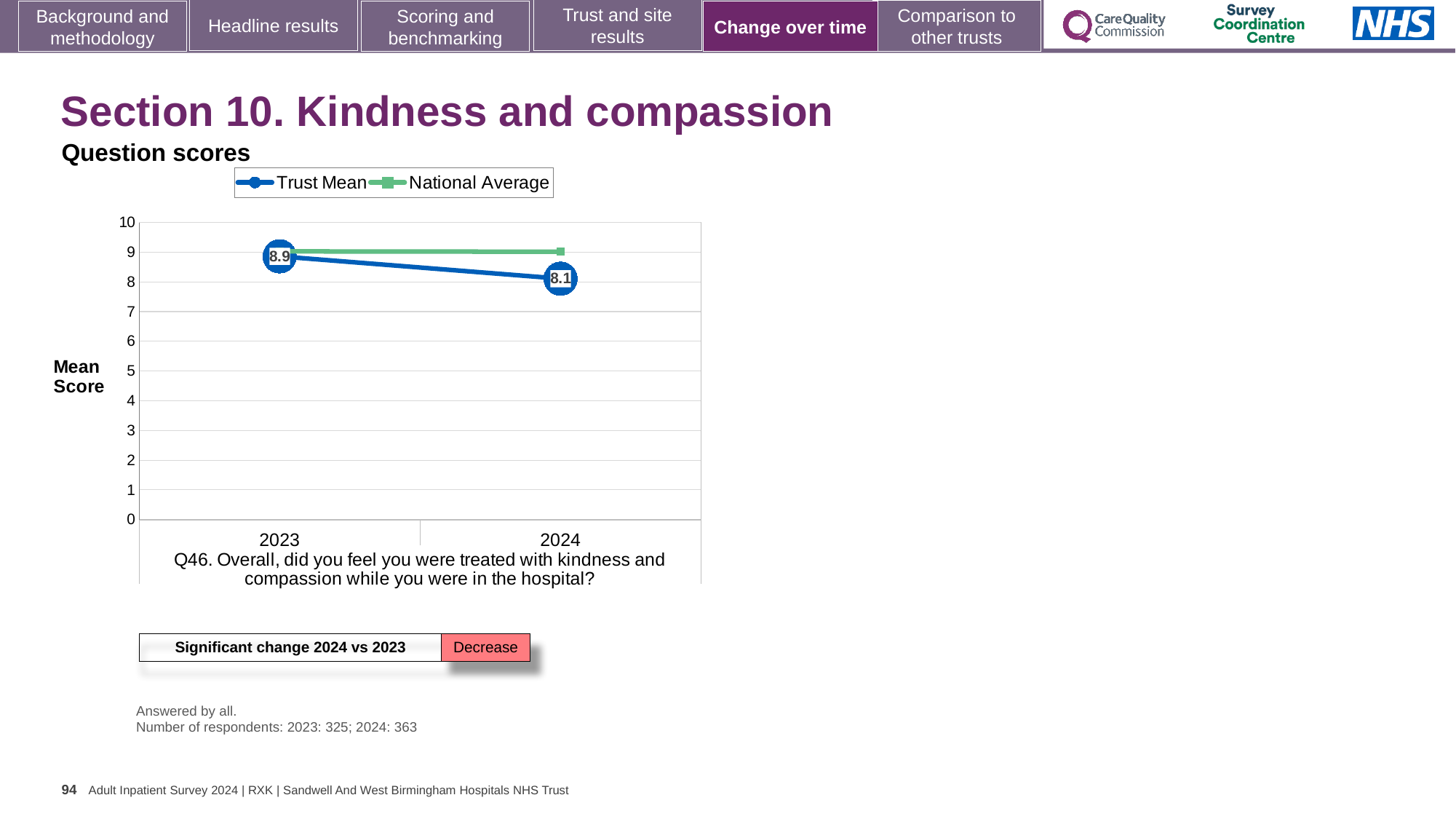
In which year is the Trust Mean score lowest? 2024 What is the difference between the Trust Mean scores for 2023 and 2024? 0.8 What does the 'Significant change 2024 vs 2023' box below the chart say? Decrease Is the National Average value for 2024 greater or less than 8? greater What is the Trust Mean score for 2023? 8.9 In which year is the Trust Mean score higher? 2023 What is the Trust Mean score for 2024? 8.1 How many series does the chart legend list? 2 How many years are plotted on the x axis of the chart? 2 What kind of chart is shown on the slide? line chart In 2024, which is larger: the Trust Mean or the National Average? National Average Does the Trust Mean rise or fall from 2023 to 2024? fall